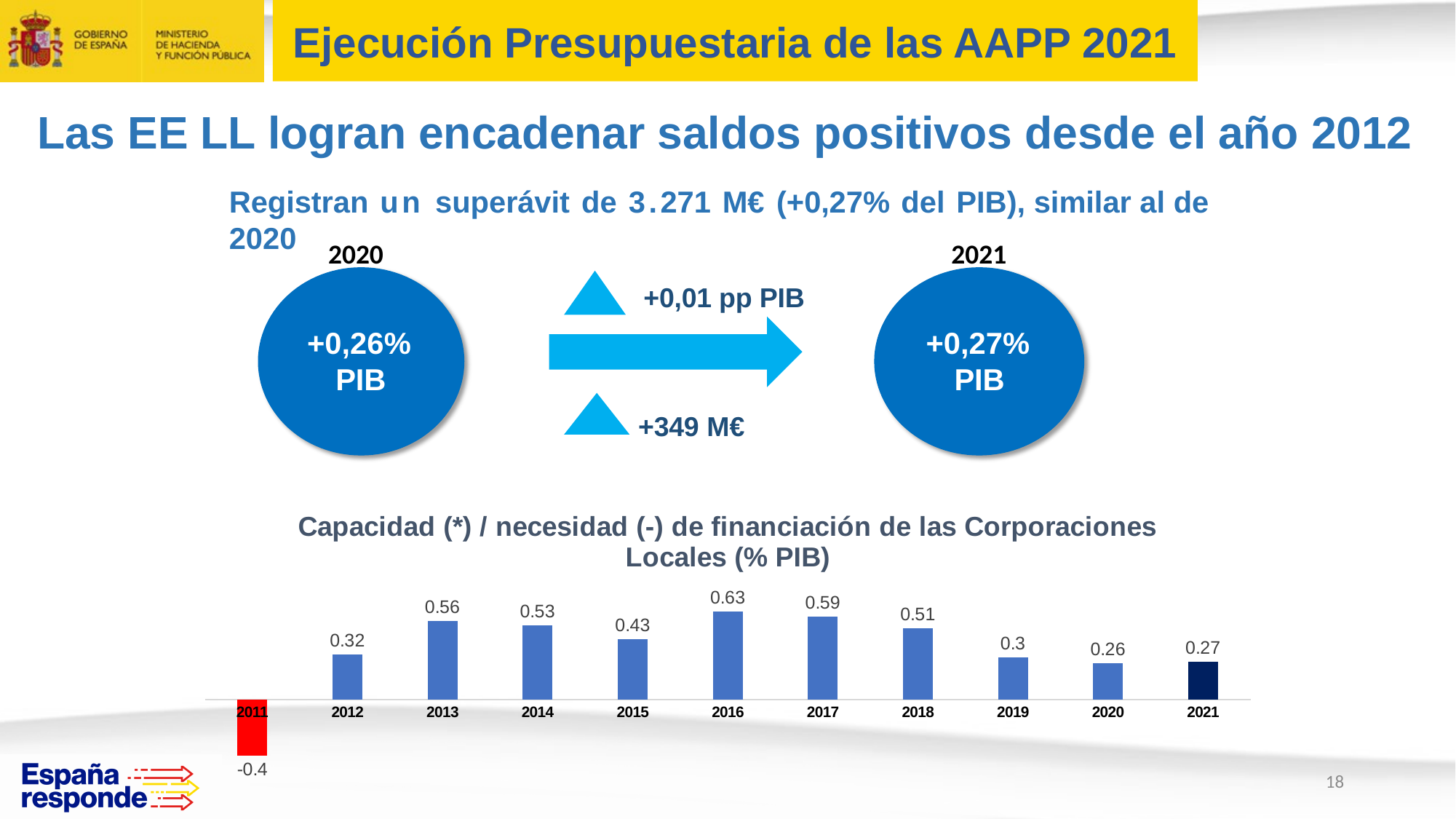
Which is larger, the value for 2013 or the value for 2014? 2013 How many years are shown in the chart? 11 Do the values rise or fall from 2016 to 2020? Fall Which year has the highest value in the chart? 2016 What is the value for 2016 in the chart? 0.63 What is the difference between the values for 2021 and 2020? 0.01 What is the difference between the values for 2016 and 2017? 0.04 What is the title of the chart? Capacidad (*) / necesidad (-) de financiación de las Corporaciones Locales (% PIB) What is the value for 2021 in the chart? 0.27 What is the value for 2011 in the chart? -0.4 Which year has the lowest value in the chart? 2011 What kind of chart is shown on the slide? Bar chart